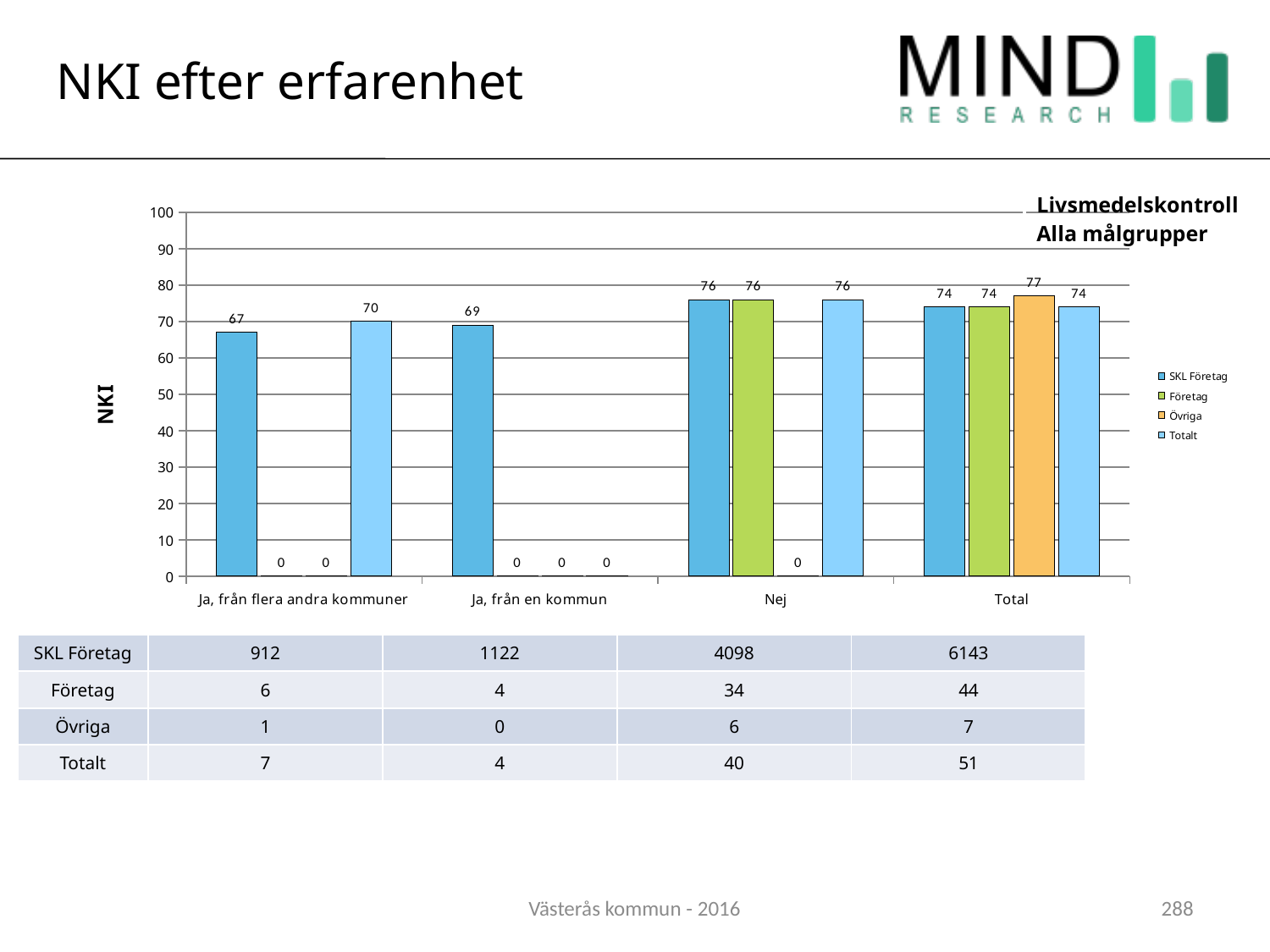
What is the NKI value for Totalt in the category 'Ja, från flera andra kommuner'? 70 Which category has the lowest NKI value for SKL Företag? Ja, från flera andra kommuner What is the NKI value for SKL Företag in the category 'Ja, från en kommun'? 69 What is the difference between the SKL Företag values for 'Nej' and 'Ja, från flera andra kommuner'? 9 How many series does the chart legend list? 4 What kind of chart is shown on the slide? Bar chart Which is larger: the Totalt value for 'Ja, från flera andra kommuner' or the SKL Företag value for 'Ja, från en kommun'? Totalt value for 'Ja, från flera andra kommuner' What is the NKI value for Övriga in the category 'Total'? 77 Which category has the highest NKI value for SKL Företag? Nej How many categories are shown on the x axis of the chart? 4 What is the NKI value for Företag in the category 'Nej'? 76 What is the NKI value for SKL Företag in the category 'Ja, från flera andra kommuner'? 67